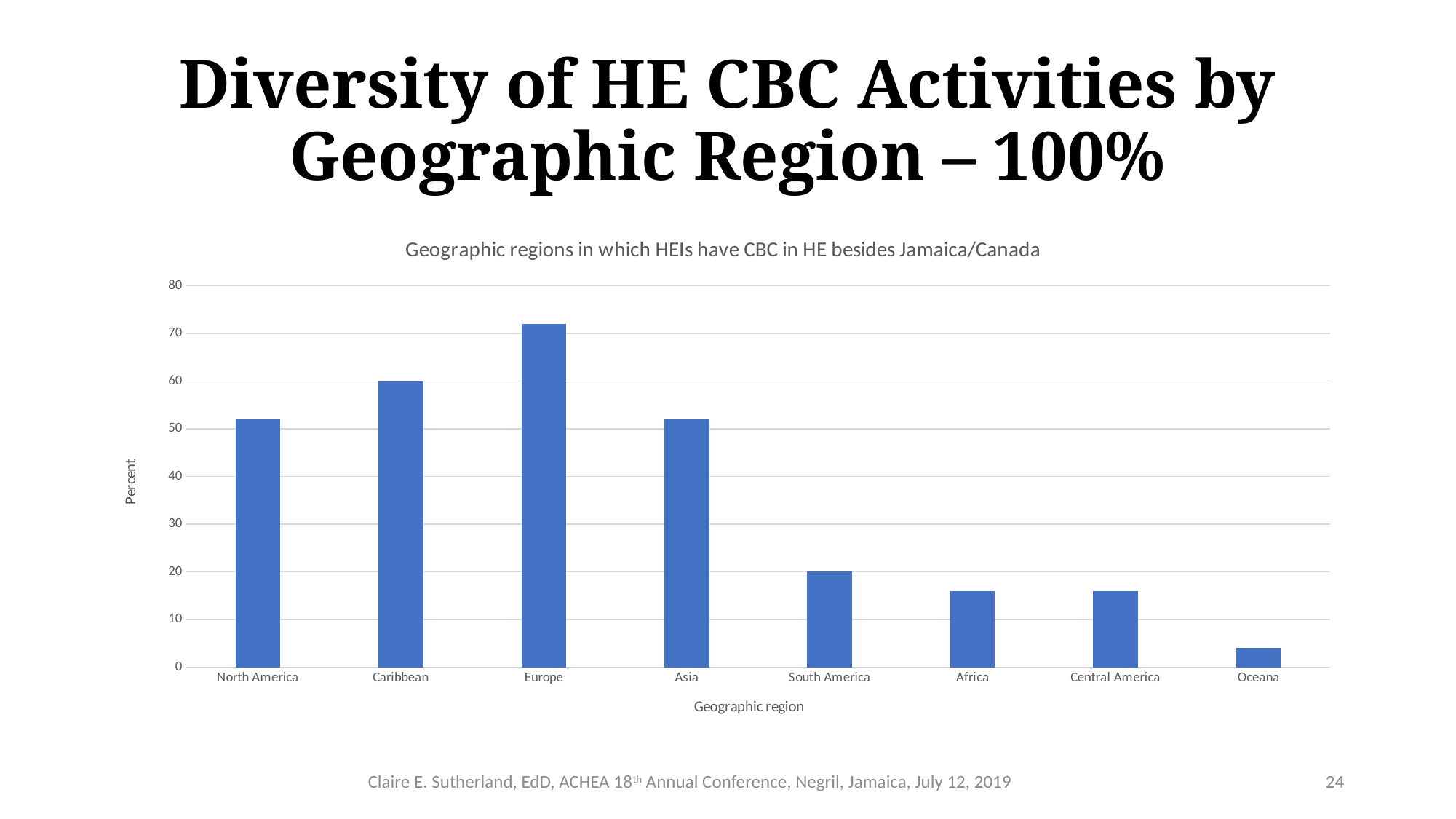
Is the value for Oceana greater or less than 10? less Which geographic region has the lowest percentage in the chart? Oceana What is the label on the vertical axis of the chart? Percent What is the title of the chart? Geographic regions in which HEIs have CBC in HE besides Jamaica/Canada Is the value for North America greater or less than 50? greater Which geographic region has the highest percentage in the chart? Europe What is the percentage value for Caribbean in the chart? 60 Is the value for Europe greater or less than 70? greater What kind of chart is shown on the slide? bar chart What is the percentage value for South America in the chart? 20 How many geographic regions are shown on the x axis of the chart? 8 Which has a larger value in the chart, Caribbean or Asia? Caribbean